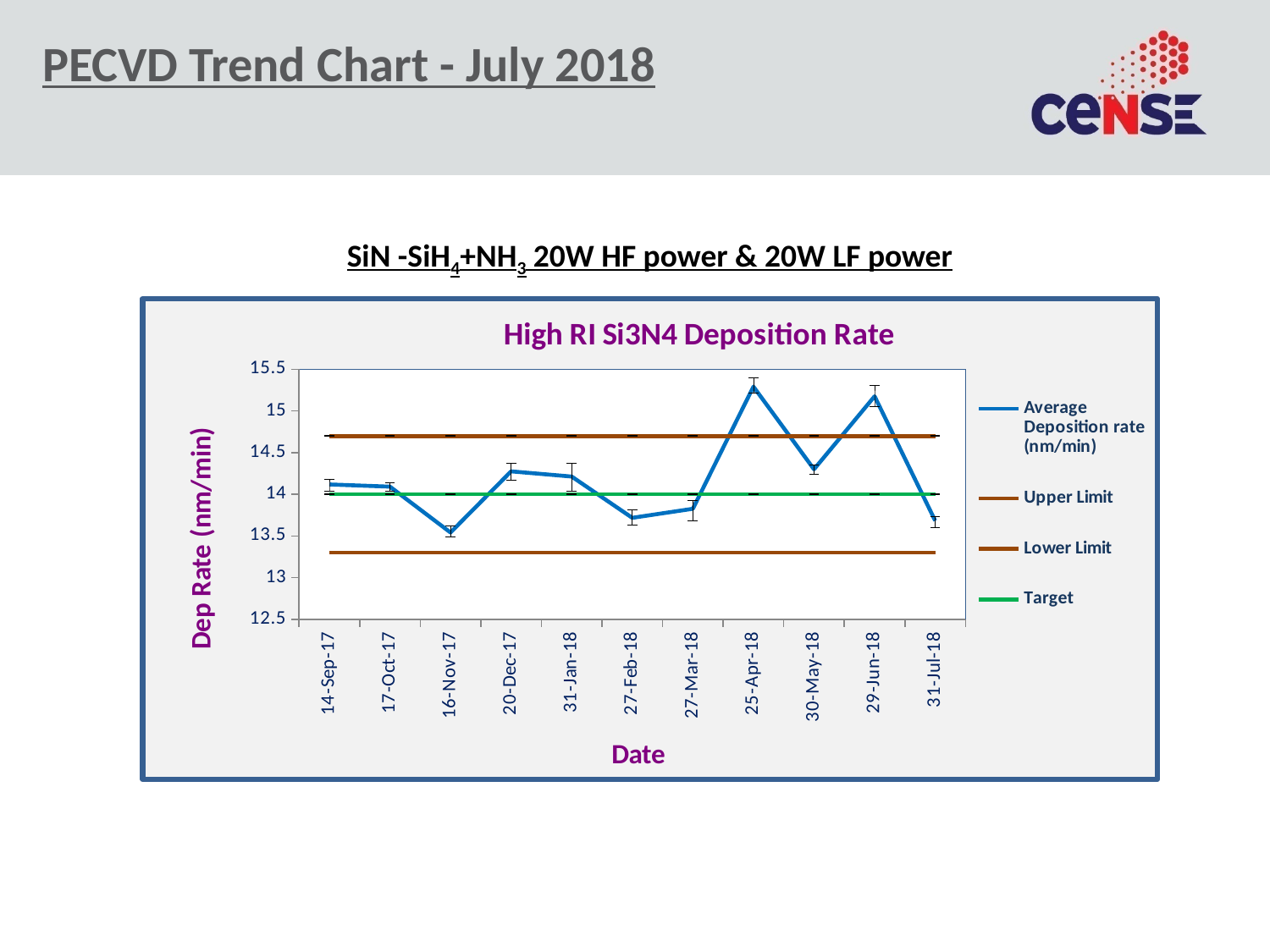
How many dates are plotted along the x axis? 11 What is the title of the chart? High RI Si3N4 Deposition Rate Which date has the larger average deposition rate, 25-Apr-18 or 30-May-18? 25-Apr-18 What value does the Target line sit at on the y axis? 14 Is the average deposition rate for 27-Feb-18 greater or less than 14? less Is the average deposition rate for 16-Nov-17 greater or less than 14? less On which date is the average deposition rate highest? 25-Apr-18 What is the label of the y axis? Dep Rate (nm/min) How many series does the chart legend list? 4 Is the average deposition rate for 29-Jun-18 greater or less than 15? greater What kind of chart is shown on the slide? line chart